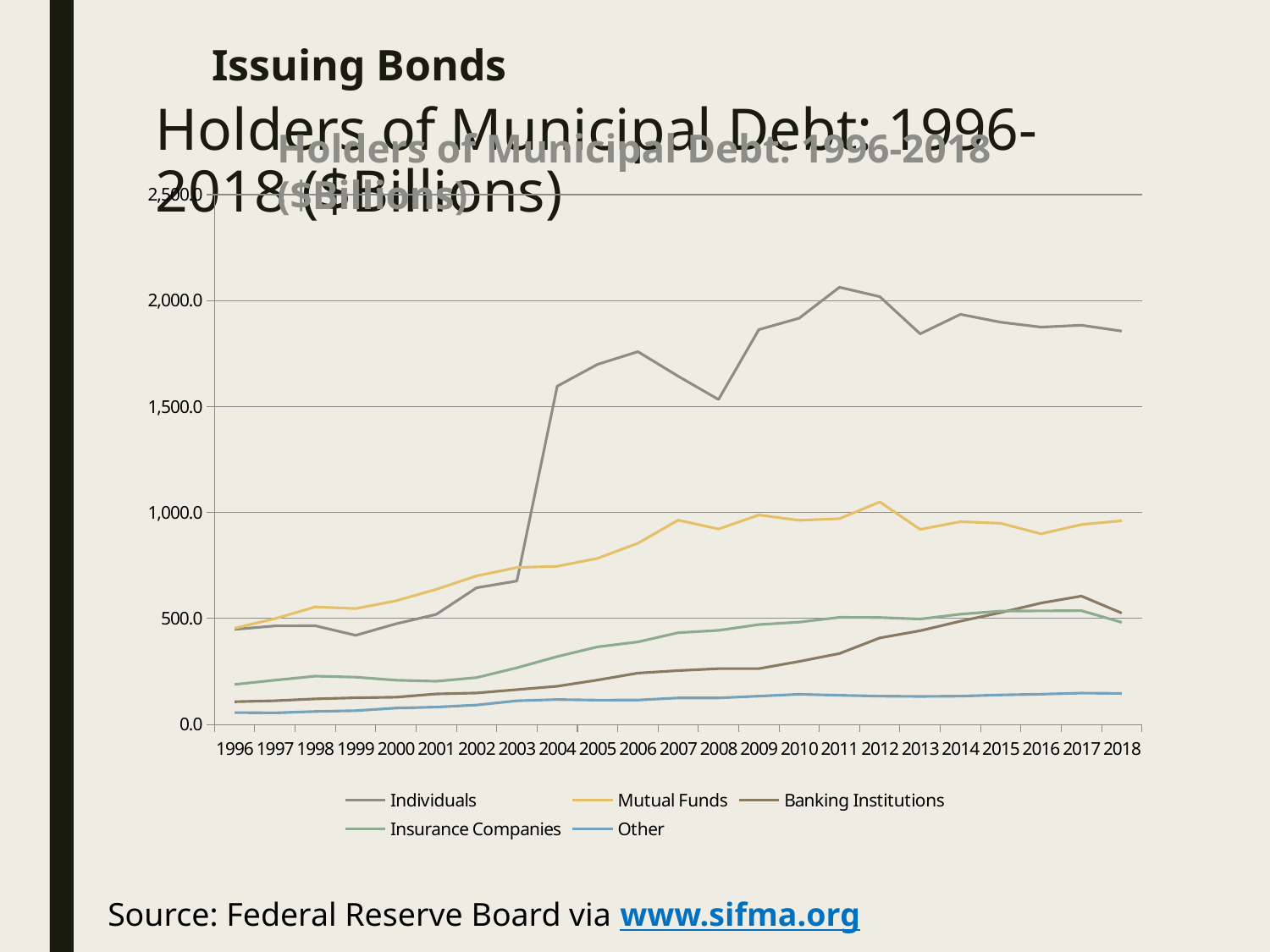
Which series has the highest value in 2018? Individuals Is the value for Other in 2018 greater or less than 500.0? less Does the Banking Institutions series generally rise or fall from 1996 to 2017? rise Is the value for Banking Institutions in 2017 greater or less than 500.0? greater In which year does the Individuals series reach its highest value? 2011 Which series has the lowest value in 2018? Other How many series does the legend list? 5 Is the value for Individuals in 2004 greater or less than 1,500.0? greater What kind of chart is shown on the slide? line chart In 2010, which is larger: Insurance Companies or Banking Institutions? Insurance Companies How many years are plotted along the x axis? 23